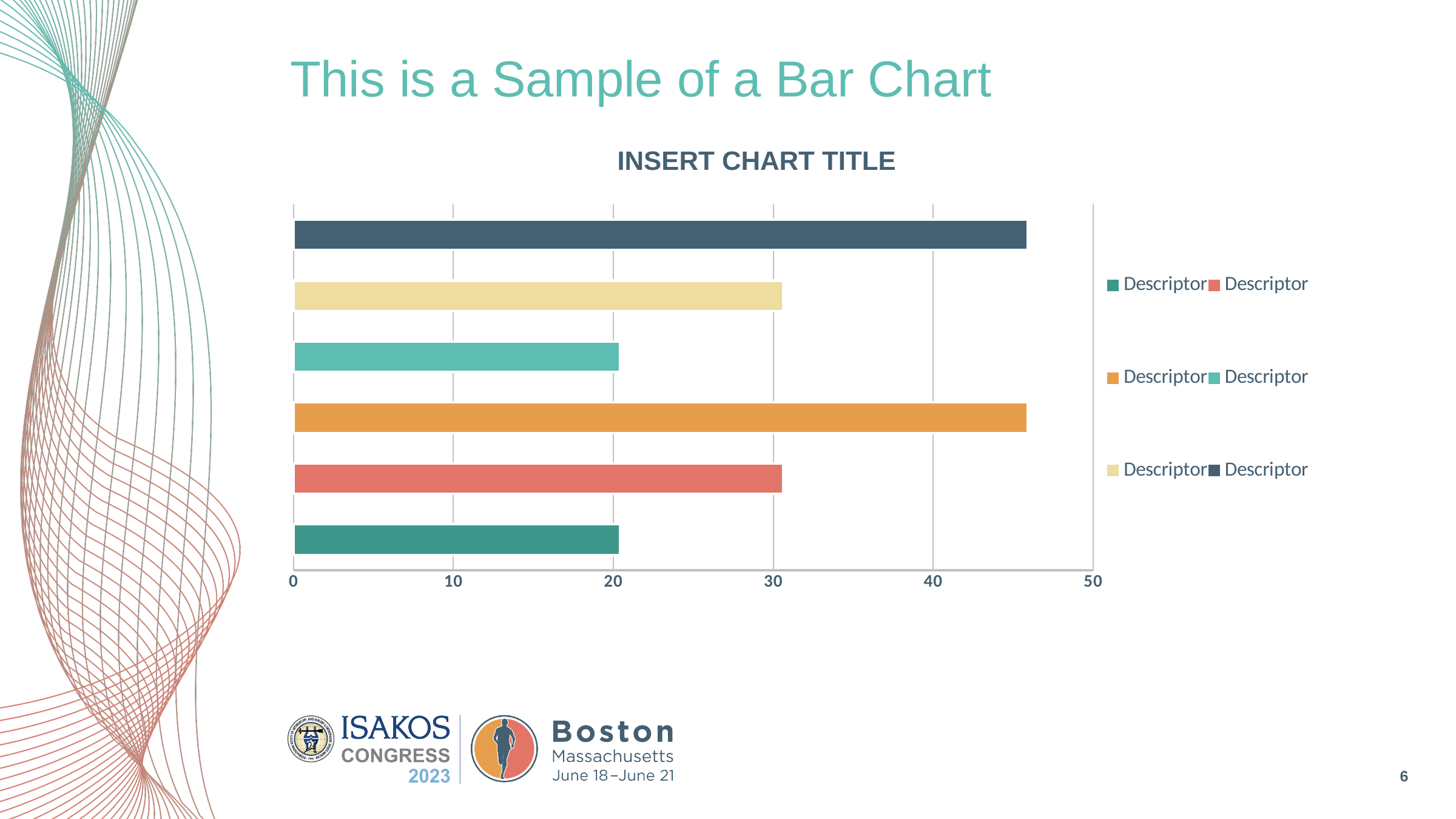
Which bar is longer, the yellow bar or the green bar at the bottom? The yellow bar Is the value of the orange bar greater or less than 40? greater How many entries does the chart legend list? 6 What is the title of the chart? INSERT CHART TITLE Is the value of the yellow bar greater or less than 40? less Which bar is longer, the orange bar or the teal bar? The orange bar What kind of chart is shown on the slide? Bar chart Is the value of the dark blue bar at the top greater or less than 40? greater How many bars are plotted in the chart? 6